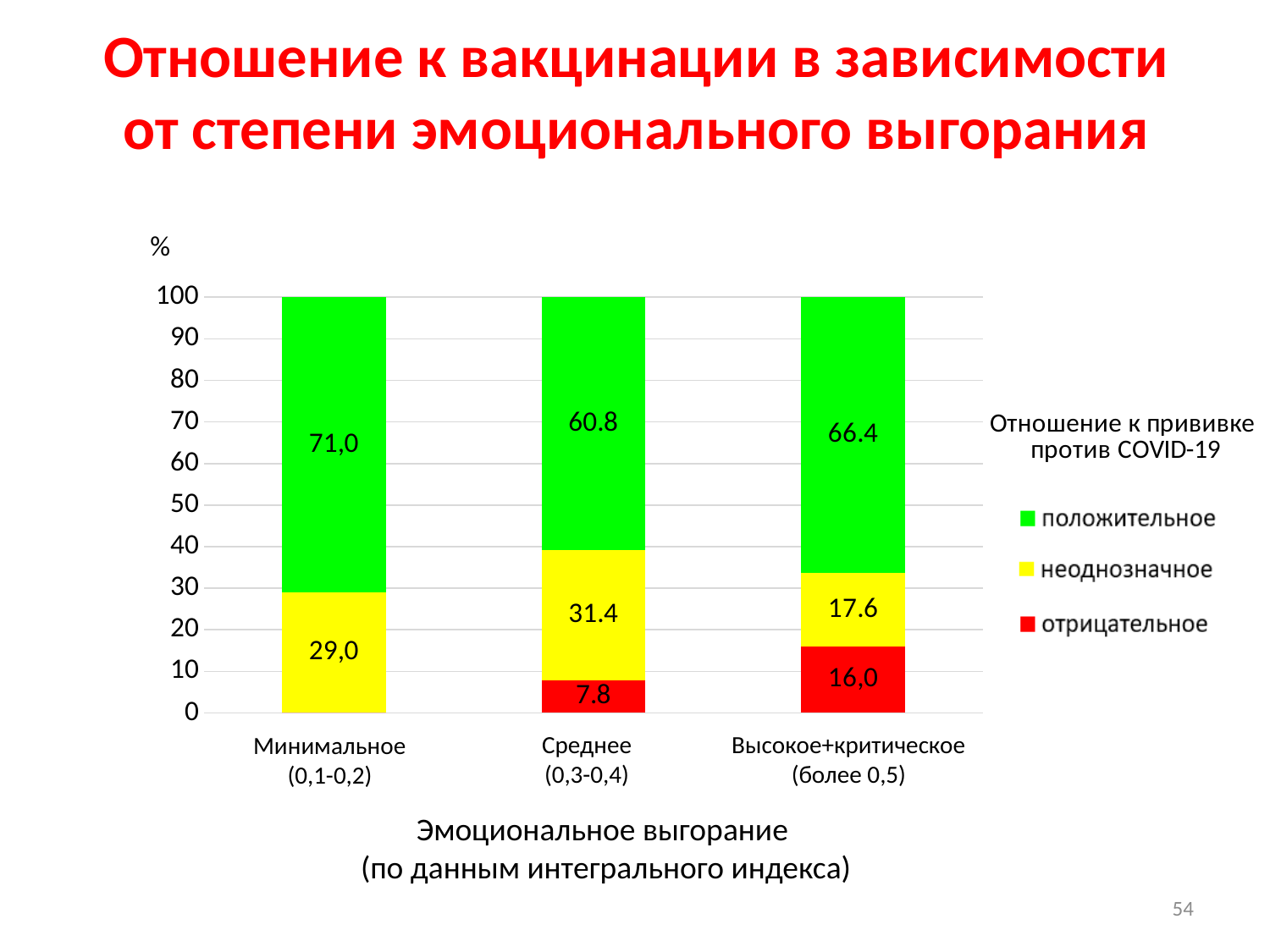
What is the value for отрицательное in the Среднее (0,3-0,4) category? 7.8 How many categories are shown on the x axis? 3 What is the value for неоднозначное in the Среднее (0,3-0,4) category? 31.4 What is the difference between the положительное values for Минимальное (0,1-0,2) and Среднее (0,3-0,4)? 10.2 Which category has the lowest value for неоднозначное? Высокое+критическое (более 0,5) What is the legend title of the chart? Отношение к прививке против COVID-19 What is the value for положительное in the Минимальное (0,1-0,2) category? 71,0 How many series does the legend list? 3 Which category has the highest value for положительное? Минимальное (0,1-0,2) What is the value for отрицательное in the Высокое+критическое (более 0,5) category? 16,0 What type of chart is shown on the slide? Stacked bar chart Which is larger: the неоднозначное value for Среднее (0,3-0,4) or for Высокое+критическое (более 0,5)? Среднее (0,3-0,4)